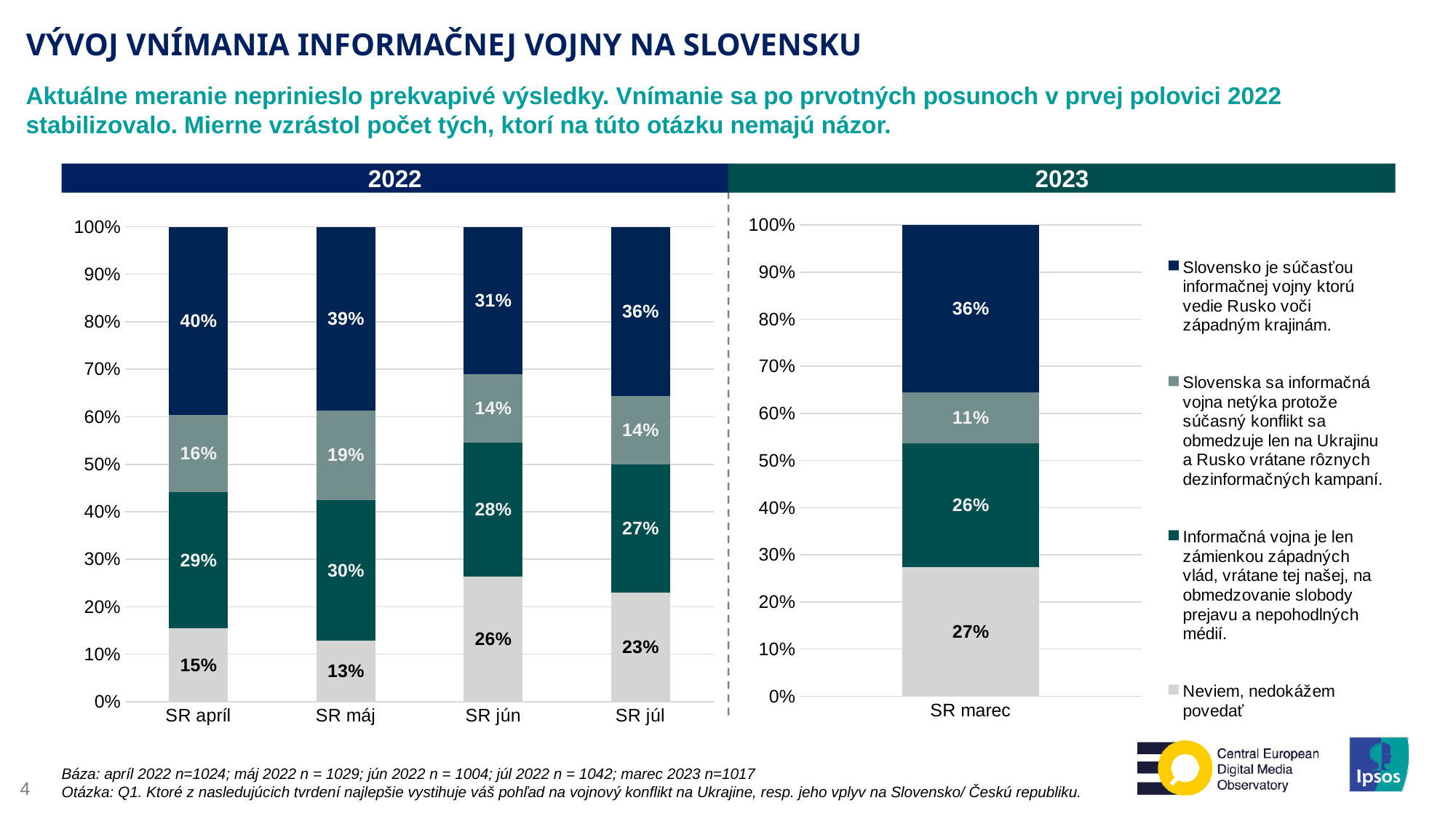
How many series does the legend list? 4 Which year does the chart on the right side of the slide cover? 2023 In the 2022 chart, what share of respondents in SR jún chose "Slovensko je súčasťou informačnej vojny ktorú vedie Rusko voči západným krajinám"? 31% In the 2023 chart, which is larger for SR marec: "Neviem, nedokážem povedať" or "Informačná vojna je len zámienkou západných vlád..."? Neviem, nedokážem povedať In the 2022 chart, what is the difference between SR apríl and SR júl for "Slovensko je súčasťou informačnej vojny..."? 4 percentage points In the 2022 chart, does the share of "Slovensko je súčasťou informačnej vojny..." rise or fall from SR apríl to SR jún? Fall In the 2023 chart, what is the value for "Informačná vojna je len zámienkou západných vlád..." in SR marec? 26% In the 2022 chart, which month has the lowest share of "Neviem, nedokážem povedať"? SR máj What type of chart is used on this slide? Stacked bar chart In the 2022 chart, which month has the highest share of "Neviem, nedokážem povedať"? SR jún How many months (categories) are shown in the 2022 chart? 4 In the 2022 chart, what is the value for "Neviem, nedokážem povedať" in SR apríl? 15%